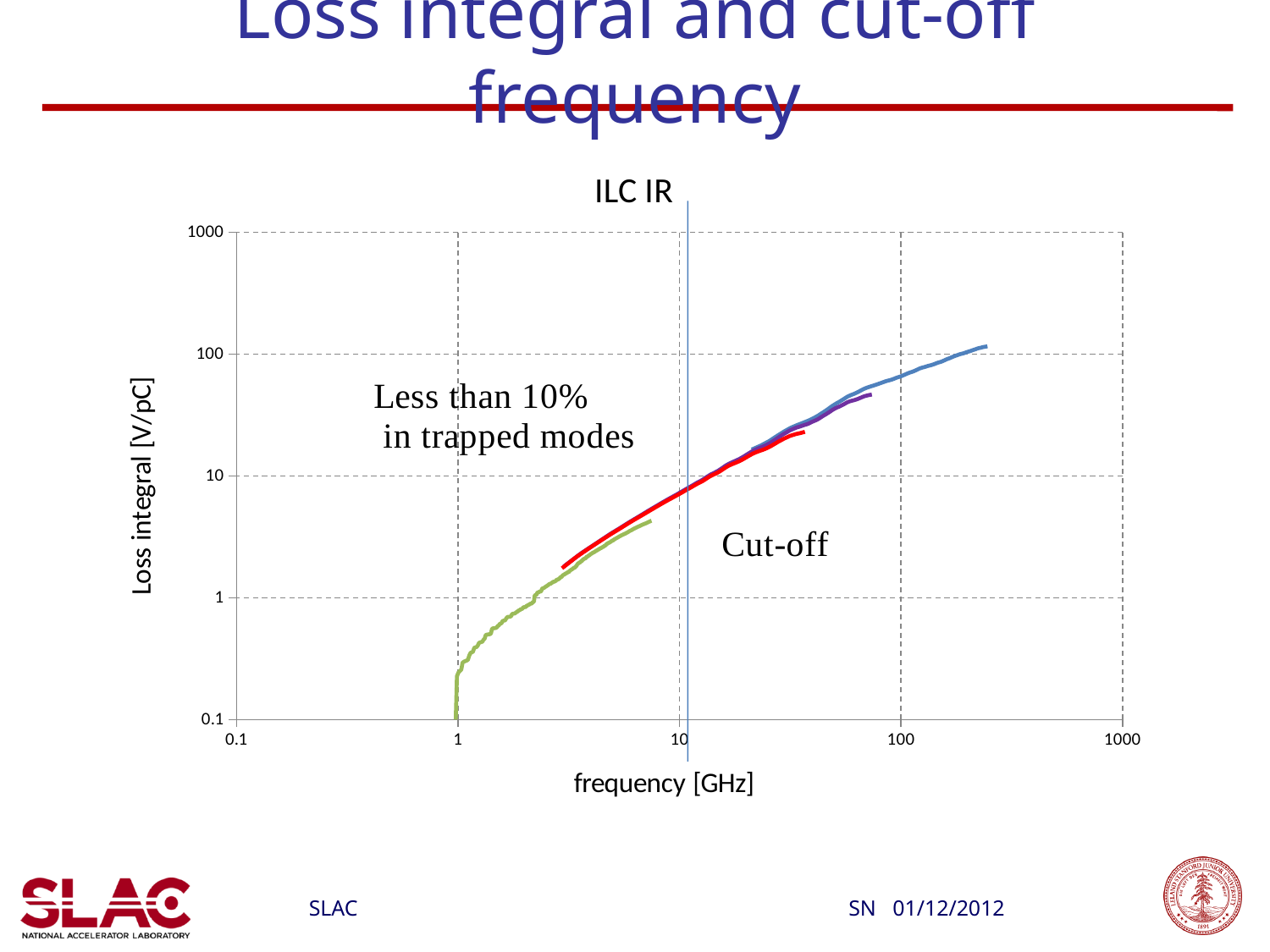
What kind of chart is shown on the slide? line chart Which line reaches the highest loss integral value on the chart, the blue line or the green line? blue line What is the label of the vertical axis of the chart? Loss integral [V/pC] Is the highest value reached by the blue line greater or less than 100? greater Is the highest value reached by the purple line greater or less than 100? less Is the highest value reached by the red line greater or less than 10? greater What is the lowest value shown on the vertical axis of the chart? 0.1 Do the plotted lines rise or fall as frequency increases along the x axis? rise What is the title of the chart? ILC IR